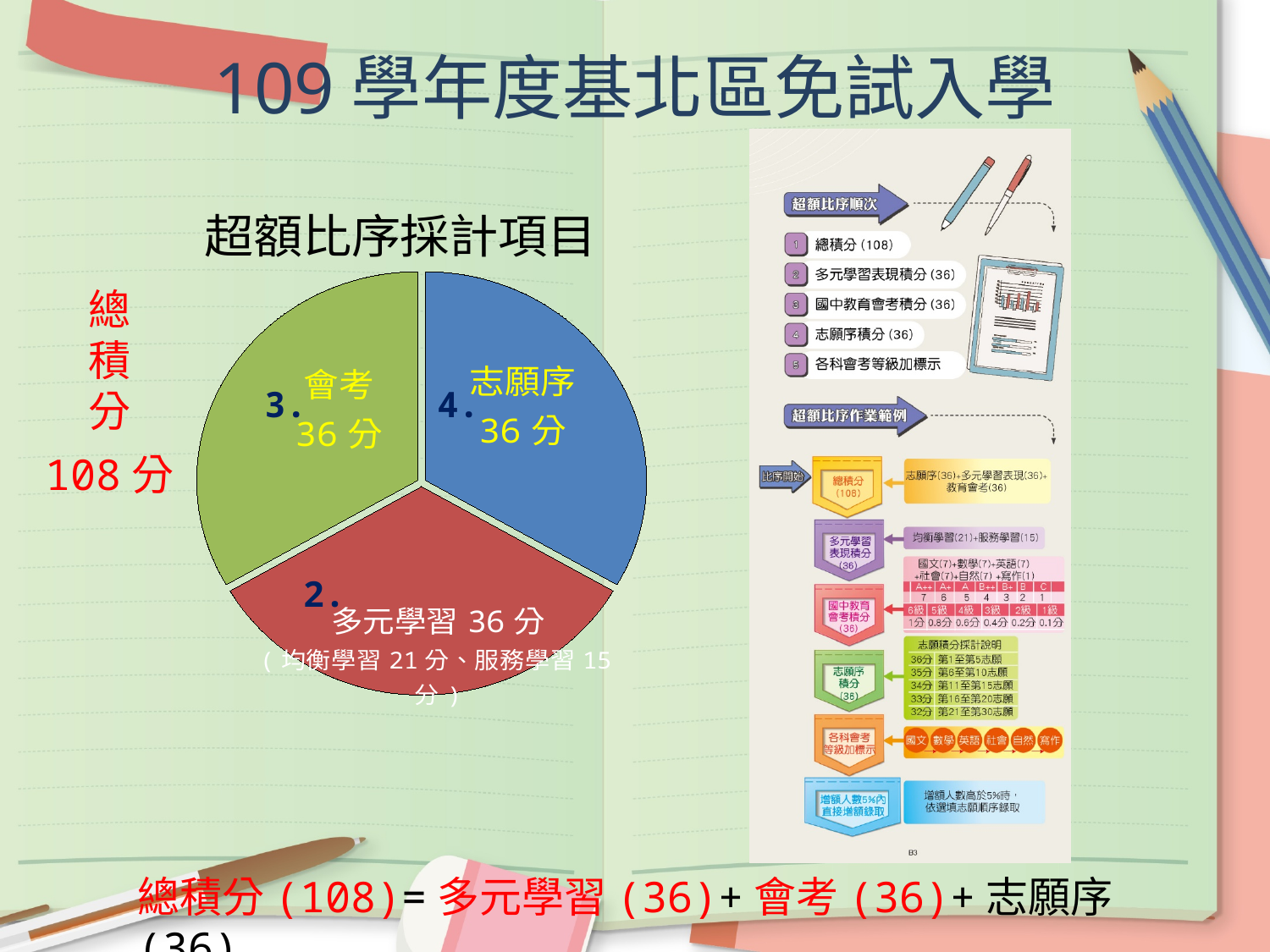
According to the label on the 多元學習 slice, how many points come from 服務學習? 15 分 What is the difference between the 會考 value and the 志願序 value? 0 分 What is the title of the pie chart? 超額比序採計項目 What kind of chart is shown on the slide? pie chart What share of the pie does the 多元學習 slice represent? one third What is the value shown for the 志願序 slice? 36 分 According to the label on the 多元學習 slice, how many points come from 均衡學習? 21 分 How many slices does the pie chart have? 3 What is the value shown for the 會考 slice? 36 分 What is the value shown for the 多元學習 slice? 36 分 Which colour is used for the 志願序 slice? blue What is the total score (總積分) shown next to the pie chart? 108 分